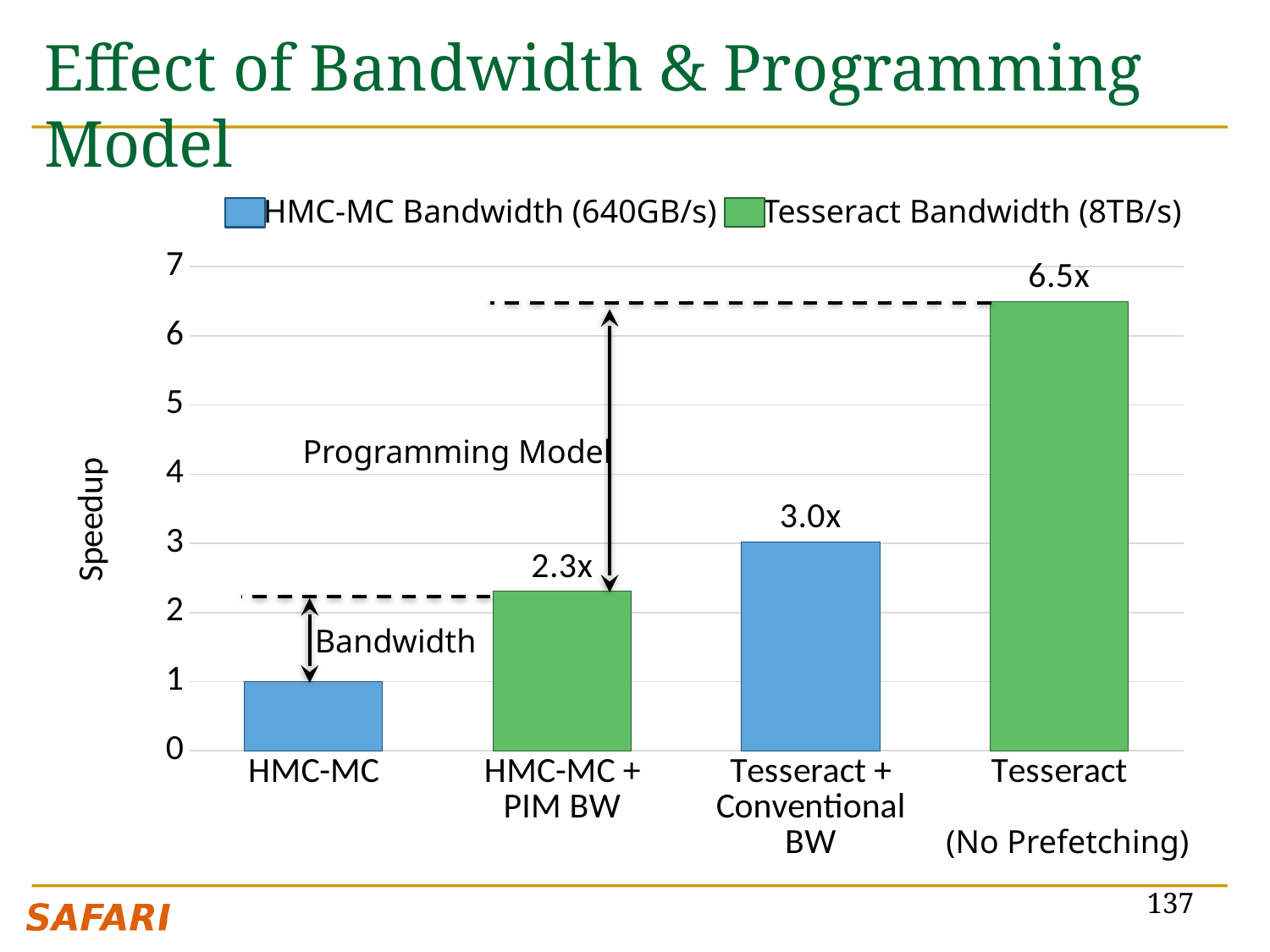
How many configurations are shown on the x axis? 4 How many series does the legend list? 2 What is the speedup shown for Tesseract + Conventional BW? 3.0x What kind of chart is shown on the slide? bar chart Which has a larger speedup, Tesseract + Conventional BW or HMC-MC + PIM BW? Tesseract + Conventional BW What is the speedup shown for HMC-MC + PIM BW? 2.3x Which configuration has the highest speedup? Tesseract (No Prefetching) Which configuration has the lowest speedup? HMC-MC What is the speedup shown for Tesseract (No Prefetching)? 6.5x Is the speedup for HMC-MC greater or less than 2? less What is the difference in speedup between Tesseract (No Prefetching) and Tesseract + Conventional BW? 3.5x What is the difference in speedup between Tesseract (No Prefetching) and HMC-MC + PIM BW? 4.2x